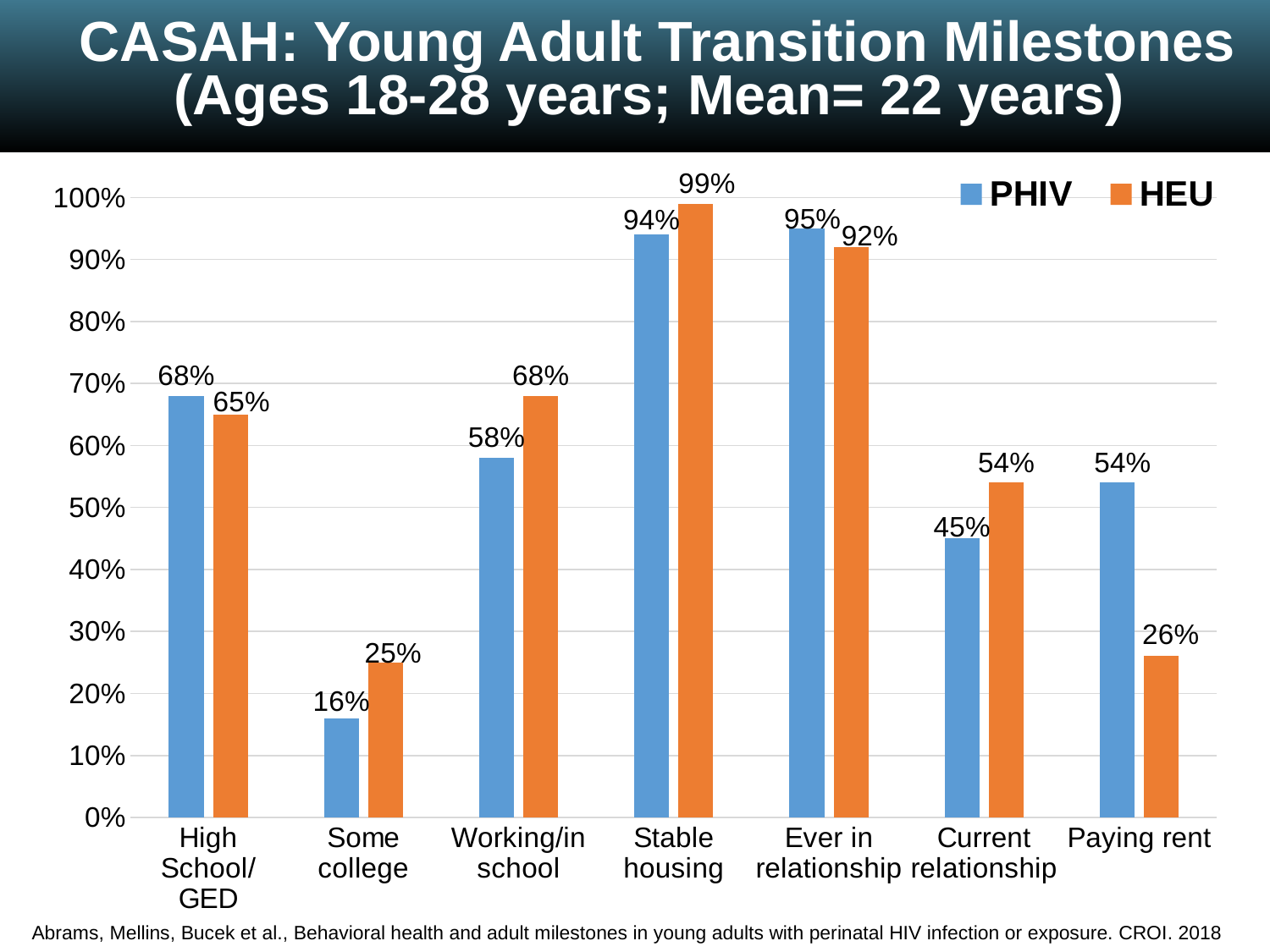
What is the difference between the PHIV and HEU values for Ever in relationship? 3% Which series is shown in orange? HEU What is the HEU value for Some college? 25% What is the PHIV value for Paying rent? 54% What kind of chart is shown on the slide? bar chart How many categories are shown on the x axis? 7 How many series does the legend list? 2 What is the PHIV value for Stable housing? 94% What is the difference between the HEU and PHIV values for Paying rent? 28% Which category has the lowest PHIV value? Some college Which category has the highest HEU value? Stable housing Which is larger for Current relationship, the PHIV value or the HEU value? HEU